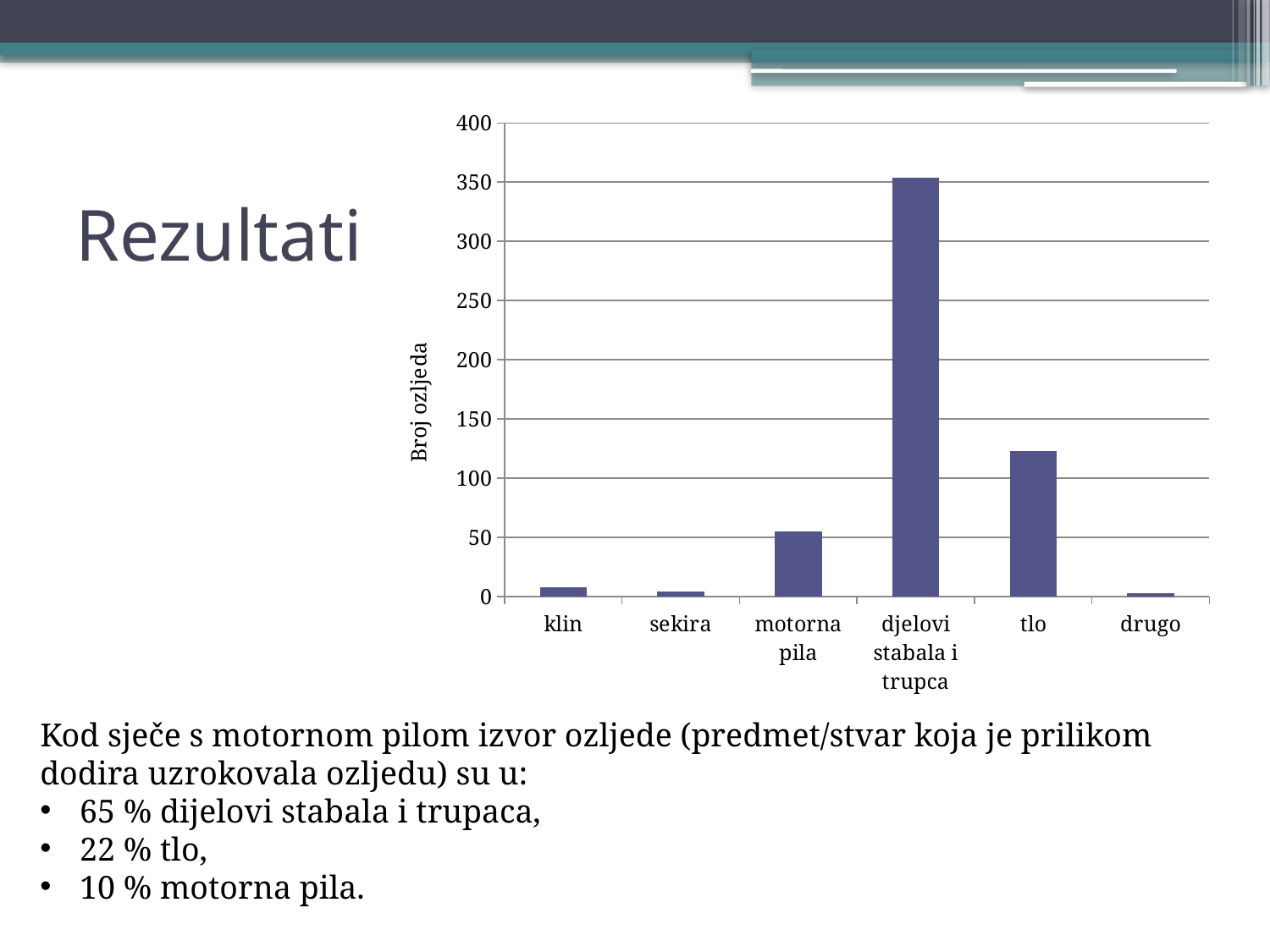
What kind of chart is shown on the slide? bar chart Is the value for tlo greater or less than 100? greater Is the value for tlo greater or less than 150? less Is the value for motorna pila greater or less than 100? less How many categories are shown on the x axis of the chart? 6 Which category has the highest number of injuries in the chart? djelovi stabala i trupca Which is larger, the value for tlo or the value for motorna pila? tlo What is the label of the vertical axis of the chart? Broj ozljeda Which is larger, the value for sekira or the value for motorna pila? motorna pila